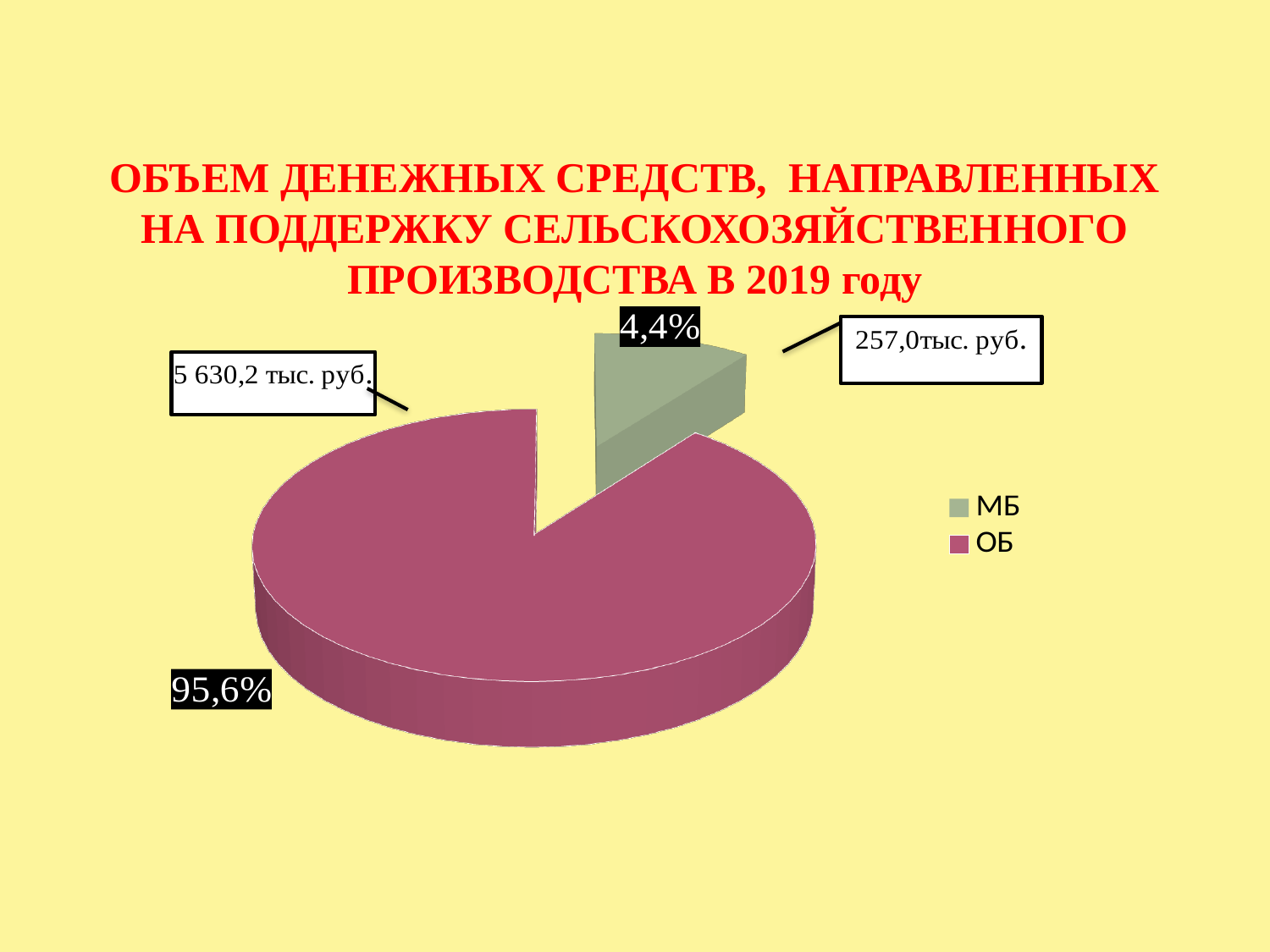
What amount in thousand rubles is shown for the МБ slice? 257,0 тыс. руб. What is the difference in percentage points between the ОБ share and the МБ share? 91,2 What amount in thousand rubles is shown for the ОБ slice? 5 630,2 тыс. руб. What percentage share does the ОБ slice have? 95,6% Which slice is the smallest? МБ What kind of chart is shown on the slide? pie chart Which slice is the largest? ОБ What percentage share does the МБ slice have? 4,4% Which is larger, the share for МБ or the share for ОБ? ОБ What colour is the ОБ slice in the pie chart? magenta (dark pink) How many slices does the pie chart have? 2 How many entries does the legend list? 2